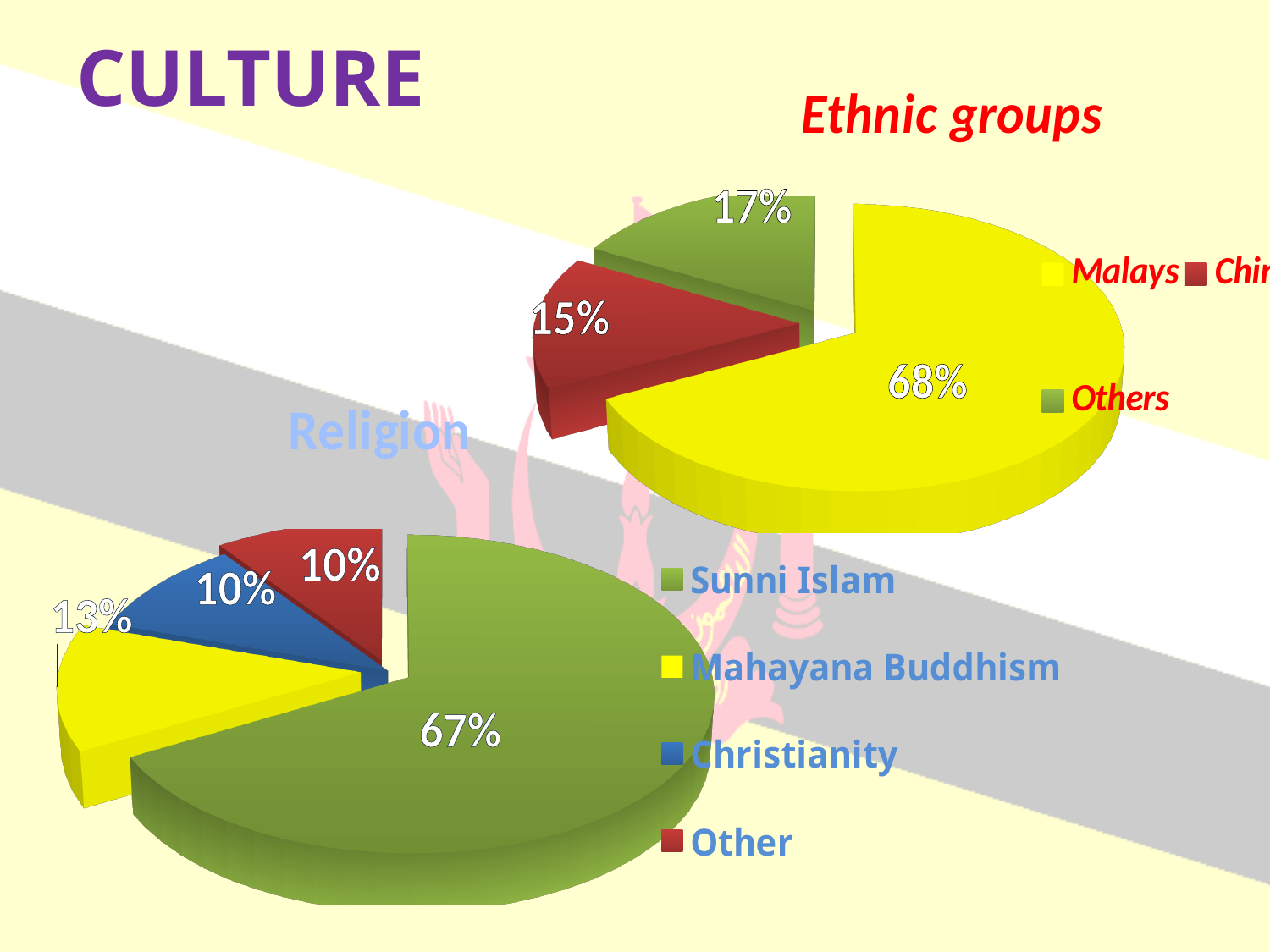
In the Ethnic groups chart, what percentage is shown for Malays? 68% In the Religion chart, what percentage is shown for Christianity? 10% What kind of chart is the Ethnic groups chart? Pie chart In the Religion chart, which is larger, the share for Mahayana Buddhism or the share for Christianity? Mahayana Buddhism In the Ethnic groups chart, what percentage is shown for Others? 17% In the Religion chart, how many categories does the legend list? 4 In the Religion chart, what percentage is shown for Mahayana Buddhism? 13% In the Ethnic groups chart, which group has the largest share? Malays In the Religion chart, which religion has the largest share? Sunni Islam In the Ethnic groups chart, what is the difference between the Malays share and the Others share? 51% In the Religion chart, what colour is the Sunni Islam slice? Green In the Religion chart, what percentage is shown for Sunni Islam? 67%